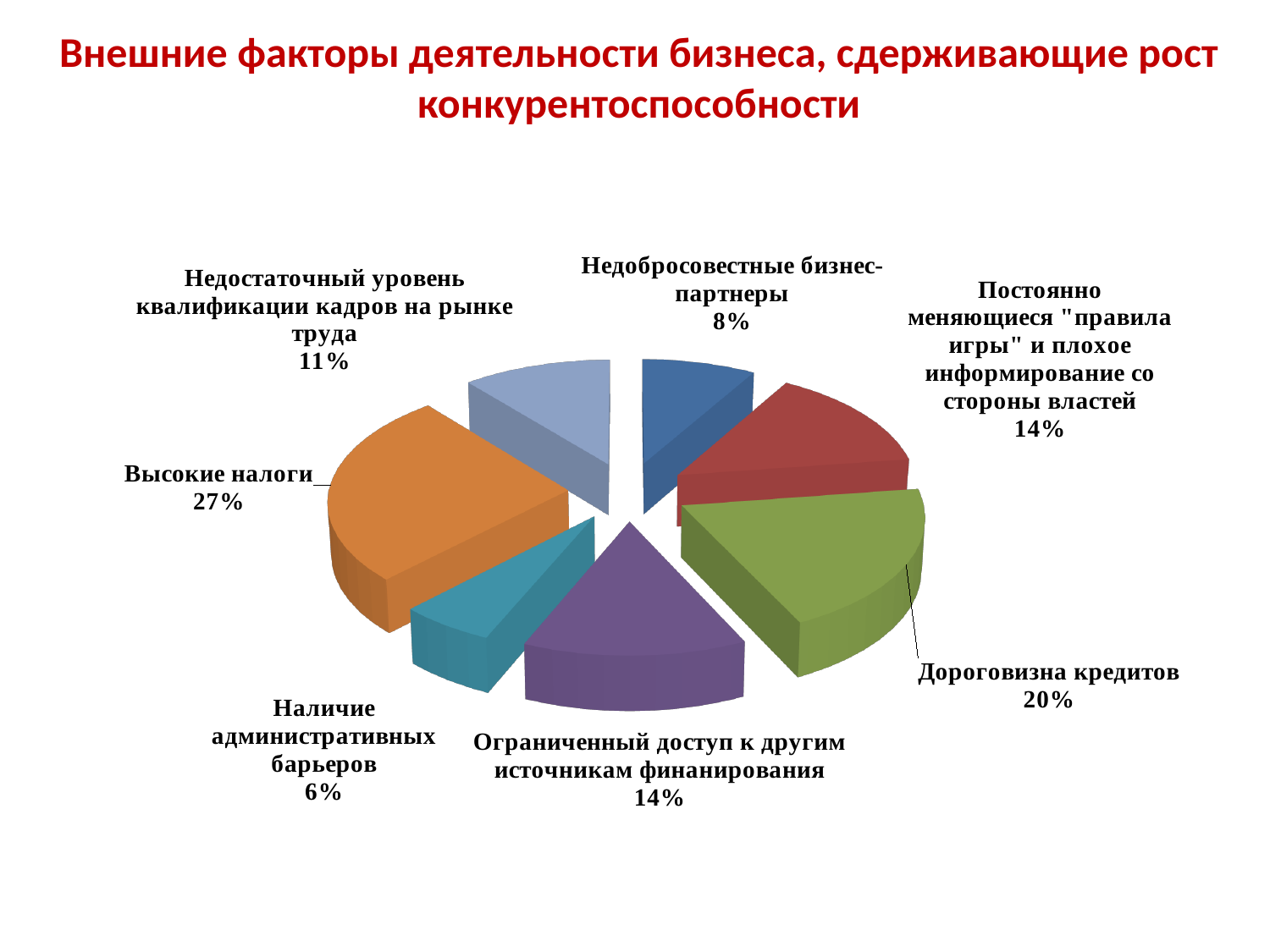
What percentage is shown for "Недобросовестные бизнес-партнеры"? 8% What is the title of the slide? Внешние факторы деятельности бизнеса, сдерживающие рост конкурентоспособности What kind of chart is shown on the slide? pie chart What percentage is shown for "Недостаточный уровень квалификации кадров на рынке труда"? 11% Which is larger: the share for "Дороговизна кредитов" or the share for "Ограниченный доступ к другим источникам финанирования"? Дороговизна кредитов Which factor has the smallest share of the pie? Наличие административных барьеров Which factor has the largest share of the pie? Высокие налоги What percentage is shown for "Наличие административных барьеров"? 6% What share of the pie is labelled "Высокие налоги"? 27% How many slices does the pie chart have? 7 What is the difference in percentage points between "Высокие налоги" and "Дороговизна кредитов"? 7 What percentage is shown for "Дороговизна кредитов"? 20%